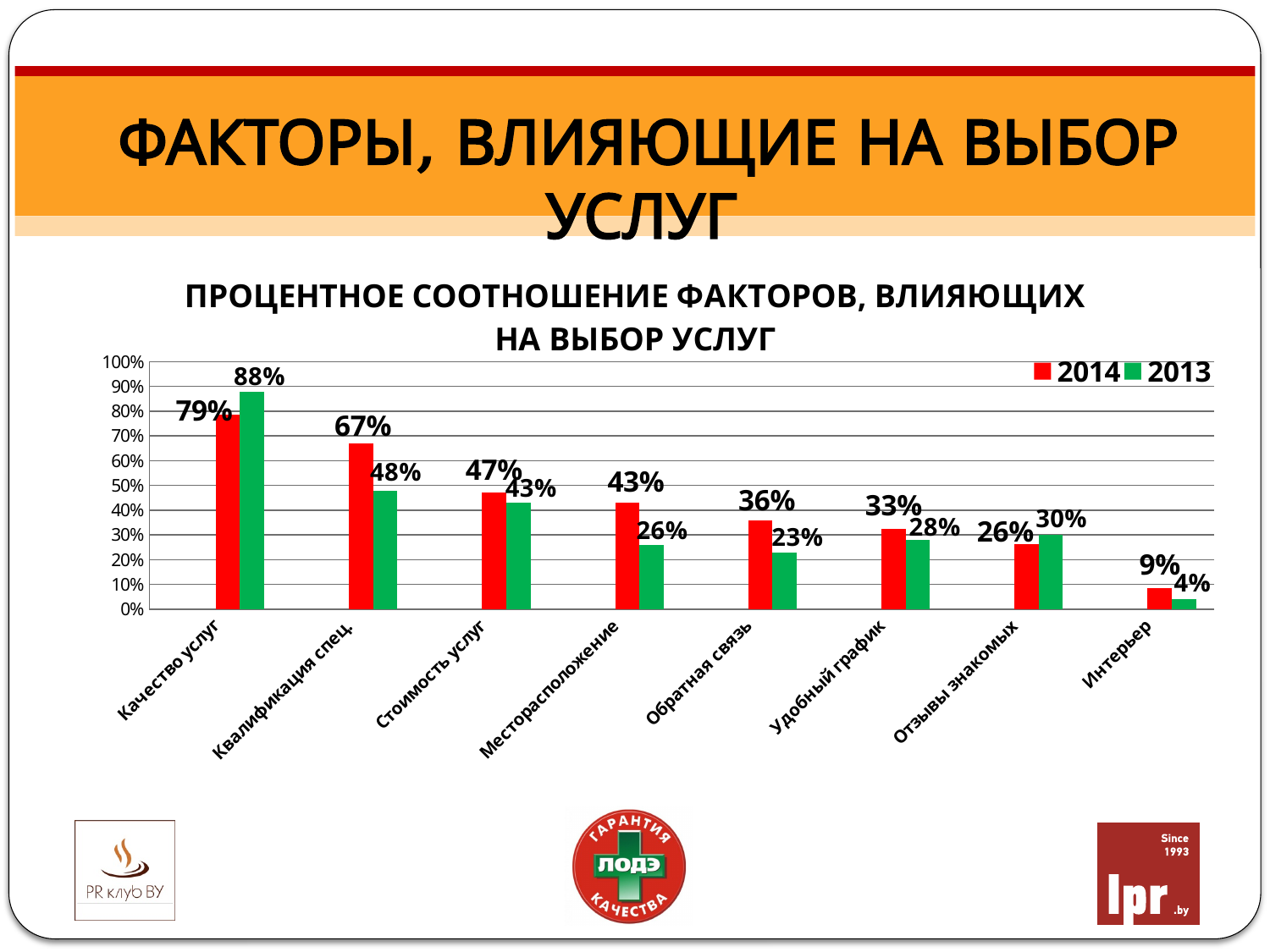
For Отзывы знакомых, which series has the larger value, 2014 or 2013? 2013 What type of chart is shown on the slide? bar chart Which category has the lowest 2014 value? Интерьер What is the 2014 value for Качество услуг? 79% Which category has the highest 2013 value? Качество услуг Do the 2014 values rise or fall from left to right along the x axis? fall What is the difference between the 2014 and 2013 values for Месторасположение? 17% Which colour represents the 2014 series in the legend? red How many series does the legend list? 2 What is the 2013 value for Интерьер? 4% How many categories are shown on the x axis? 8 What is the 2013 value for Квалификация спец.? 48%